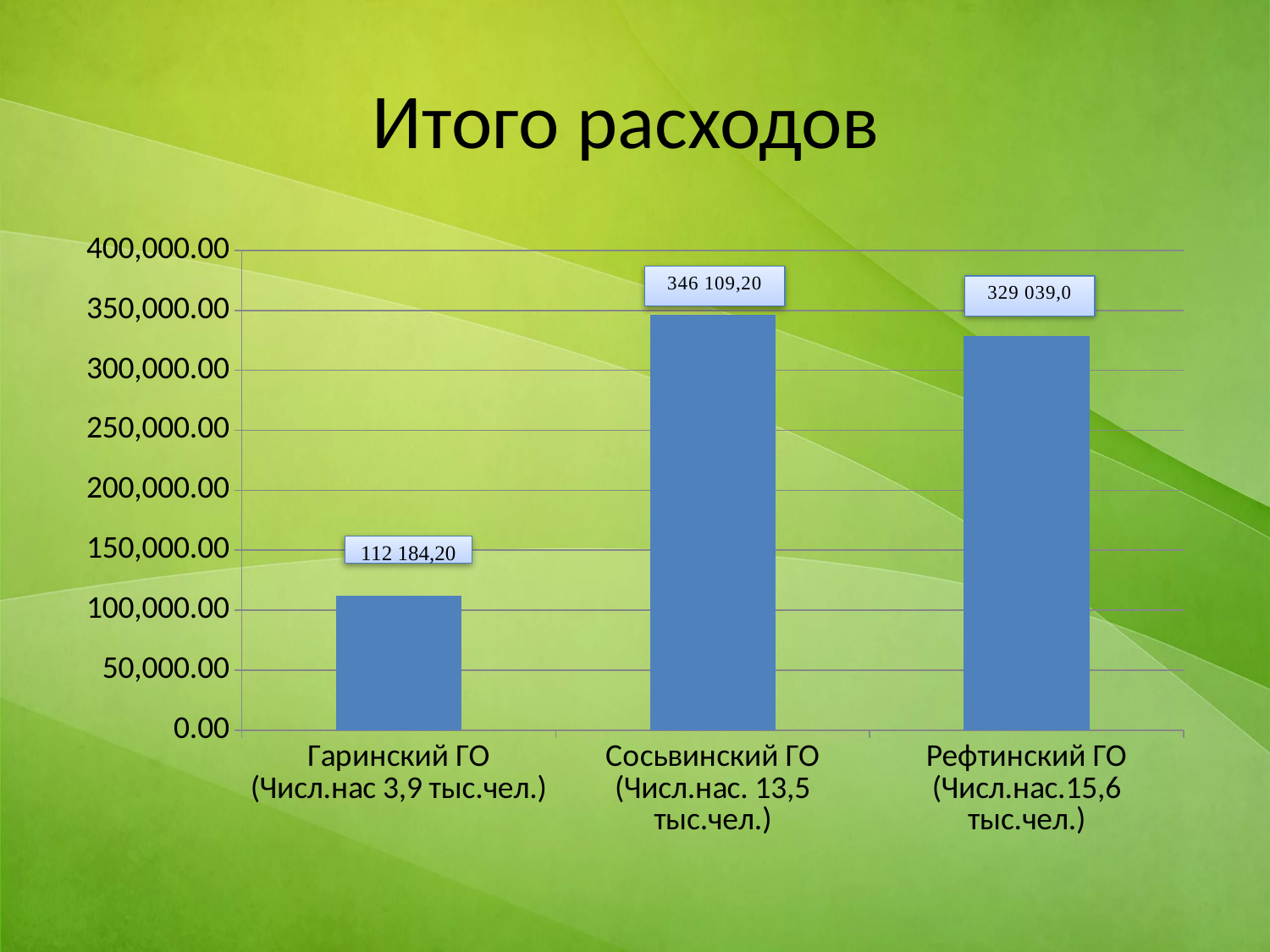
What is the value for Сосьвинский ГО? 346 109,20 What is the value for Рефтинский ГО? 329 039,0 What is the value for Гаринский ГО? 112 184,20 Is the value for Гаринский ГО greater or less than 150,000.00? less Which category has the highest value? Сосьвинский ГО What is the title of the chart? Итого расходов What is the difference between the values for Сосьвинский ГО and Гаринский ГО? 233 925,00 What kind of chart is shown on the slide? bar chart How many categories are shown in the chart? 3 What is the difference between the values for Сосьвинский ГО and Рефтинский ГО? 17 070,20 Which is larger, the value for Рефтинский ГО or the value for Гаринский ГО? Рефтинский ГО Which category has the lowest value? Гаринский ГО